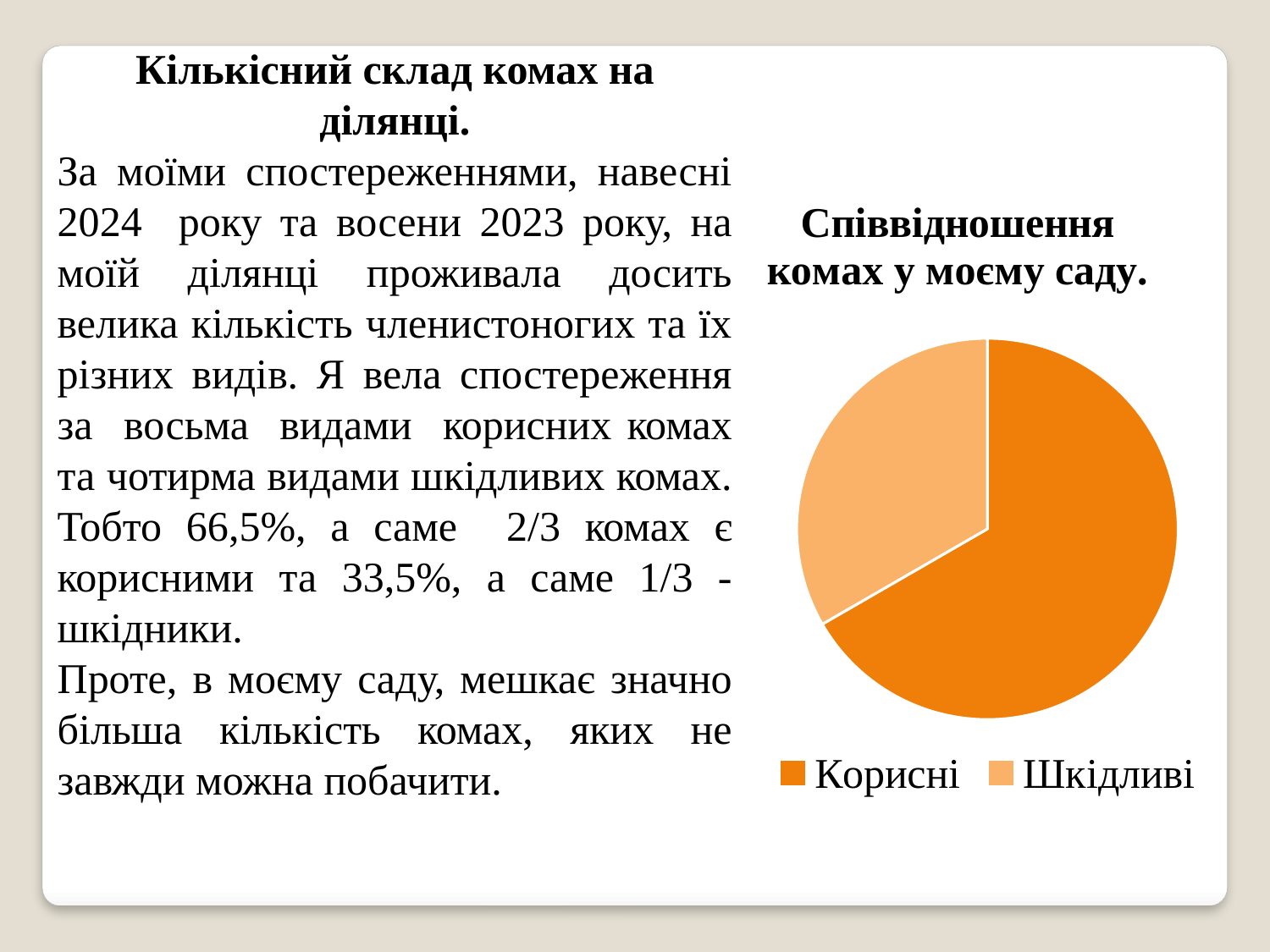
What is the title of the pie chart? Співвідношення комах у моєму саду. What kind of chart is shown on the slide? pie chart How many entries does the legend of the pie chart list? 2 Does the Шкідливі slice take up more or less than half of the pie chart? less Which category has the largest slice in the pie chart? Корисні Which slice is larger in the pie chart, Корисні or Шкідливі? Корисні Which category has the smallest slice in the pie chart? Шкідливі Does the Корисні slice take up more or less than half of the pie chart? more How many slices does the pie chart have? 2 Which category is shown in the darker orange colour in the pie chart? Корисні